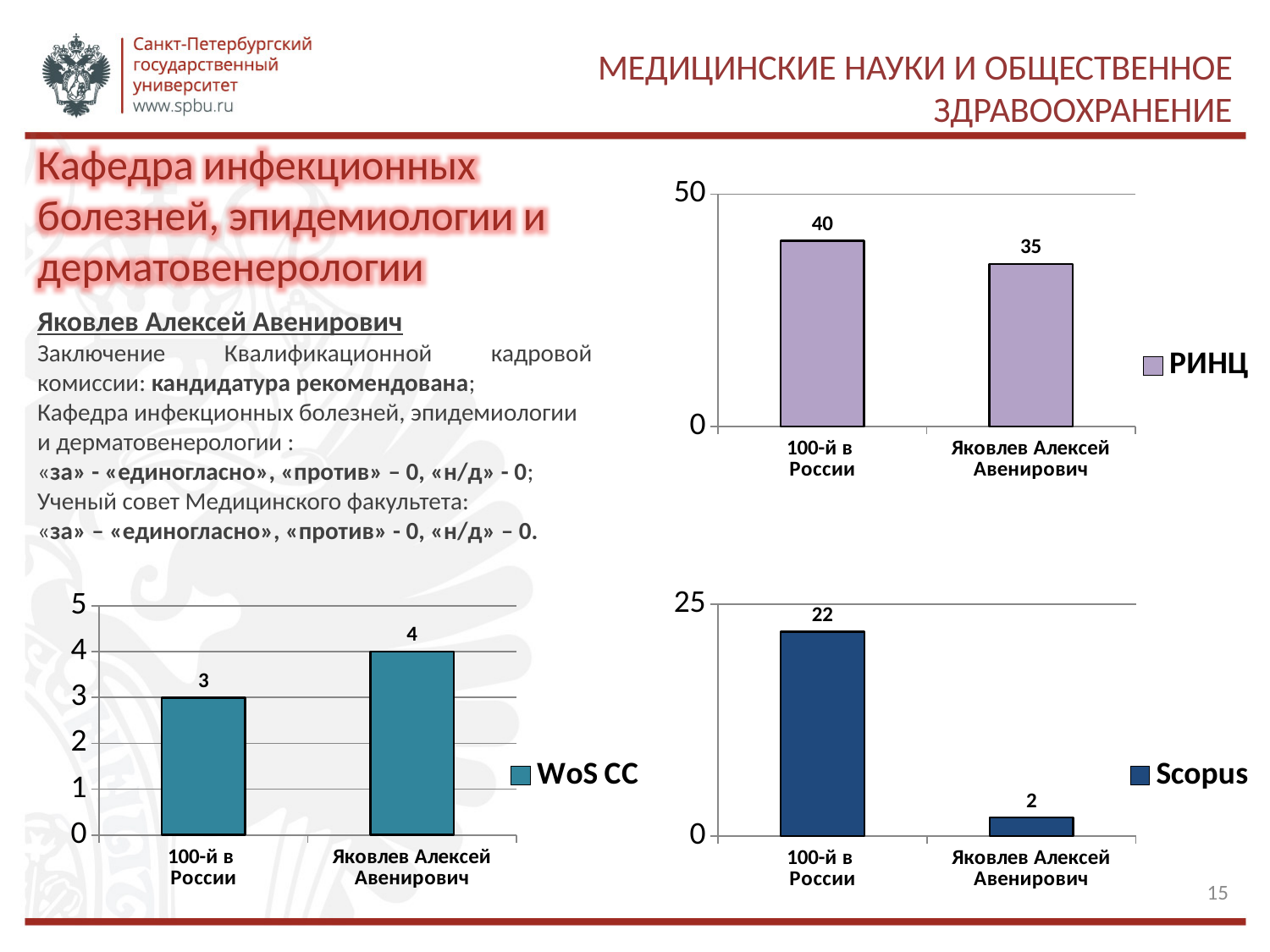
In the Scopus chart, what is the difference between the values for 100-й в России and Яковлев Алексей Авенирович? 20 In the Scopus chart, what is the value for Яковлев Алексей Авенирович? 2 In the РИНЦ chart, what is the value for Яковлев Алексей Авенирович? 35 In the Scopus chart, what is the value for 100-й в России? 22 In the РИНЦ chart, what is the value for 100-й в России? 40 In the Scopus chart, which category has the lower value? Яковлев Алексей Авенирович What kind of chart is the Scopus chart? Bar chart In the РИНЦ chart, what is the difference between the values for 100-й в России and Яковлев Алексей Авенирович? 5 How many categories does the РИНЦ chart show? 2 In the WoS CC chart, which category has the higher value? Яковлев Алексей Авенирович In the WoS CC chart, what is the difference between the values for Яковлев Алексей Авенирович and 100-й в России? 1 In the WoS CC chart, what is the value for Яковлев Алексей Авенирович? 4